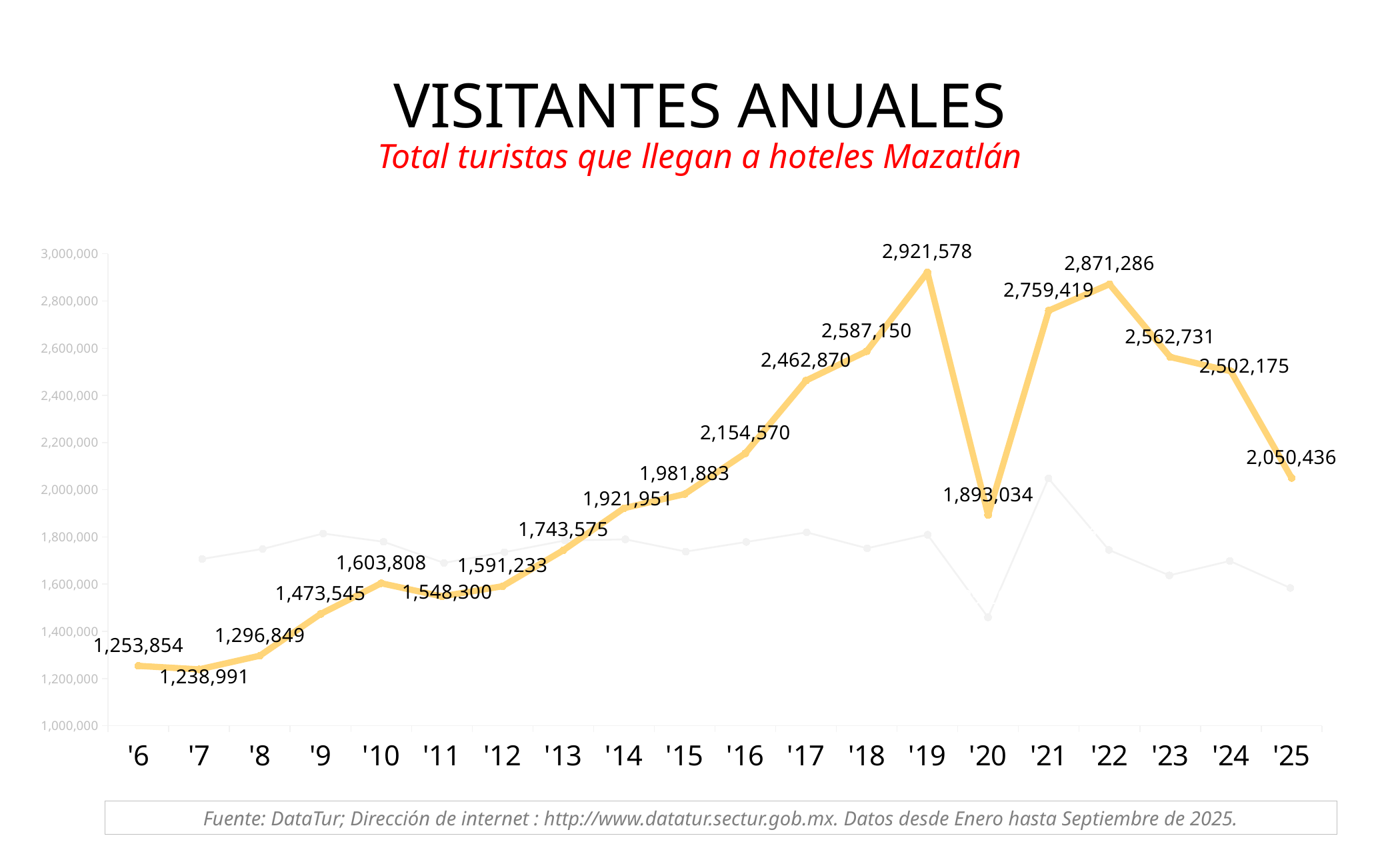
What is the value for '20? 1,893,034 What is the value for '19? 2,921,578 Do the values rise or fall from '6 to '19? rise What is the difference between the values for '19 and '20? 1,028,544 Is the value for '20 greater or less than 2,000,000? less Which year has the highest value? '19 How many years are plotted on the x axis? 20 What is the value for '25? 2,050,436 Which year has the lowest value? '7 What kind of chart is shown? line chart Which is larger, the value for '21 or the value for '22? '22 What is the difference between the values for '24 and '25? 451,739